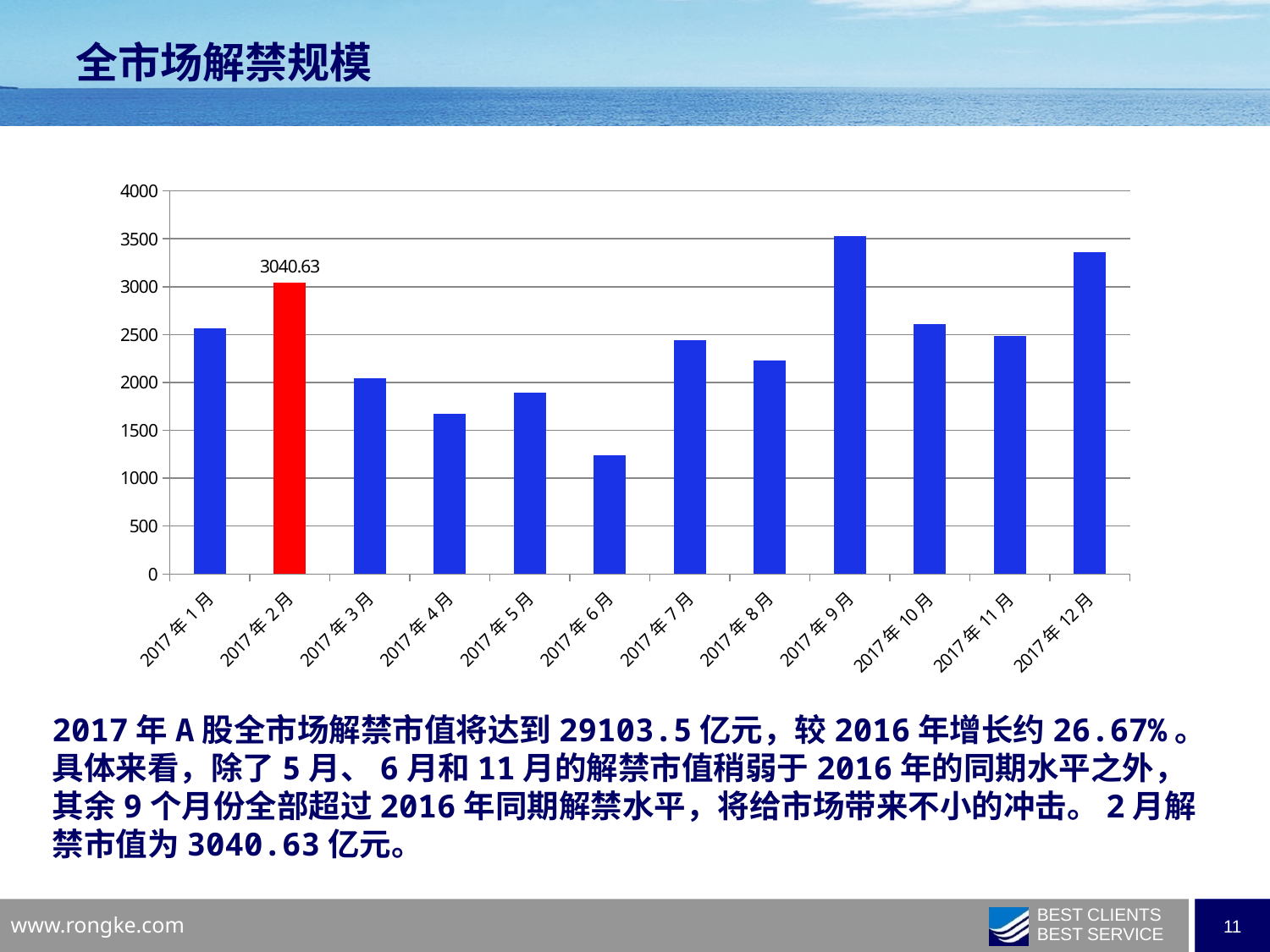
Which month has the highest bar? 2017年9月 What is the value shown for 2017年2月? 3040.63 Is the value for 2017年9月 greater or less than 3000? greater Which month has the lowest bar? 2017年6月 Is the value for 2017年6月 greater or less than 1500? less What kind of chart is shown on the slide? bar chart Is the value for 2017年4月 greater or less than 2000? less How many months are shown on the x axis? 12 Which is larger, the value for 2017年9月 or 2017年12月? 2017年9月 Which month's bar is coloured red? 2017年2月 Which is larger, the value for 2017年1月 or 2017年3月? 2017年1月